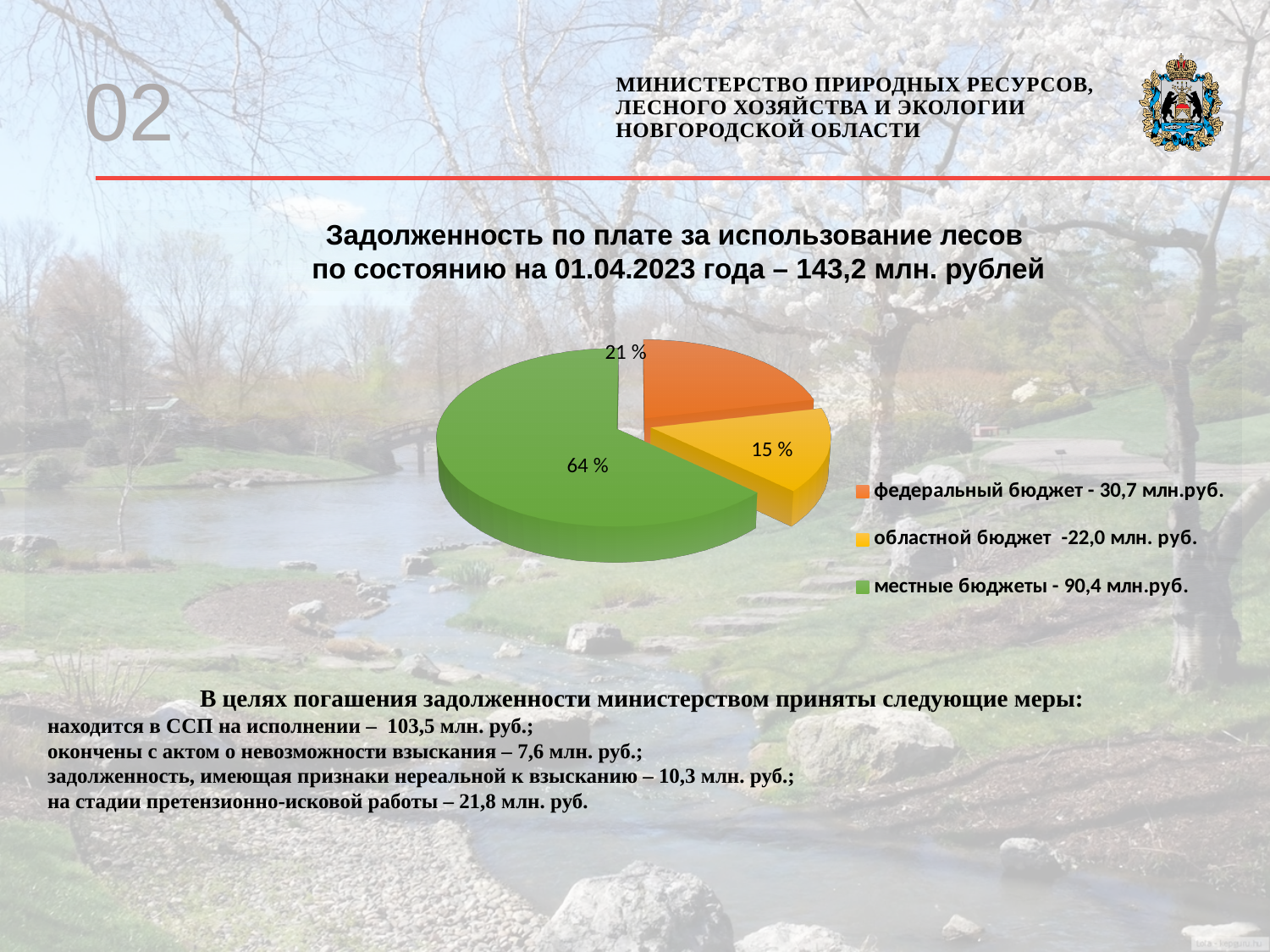
By how many percentage points does the share of местные бюджеты exceed the share of федеральный бюджет? 43 Which category has the largest slice of the pie? местные бюджеты What share of the pie does федеральный бюджет take? 21 % What share of the pie does местные бюджеты take? 64 % According to the legend, what is the debt amount for местные бюджеты? 90,4 млн.руб. Which is larger, the slice for федеральный бюджет or the slice for областной бюджет? федеральный бюджет How many slices does the pie chart have? 3 What colour is the slice for федеральный бюджет? orange What kind of chart is shown on the slide? pie chart According to the legend, what is the debt amount for областной бюджет? 22,0 млн. руб. Which category has the smallest slice of the pie? областной бюджет What share of the pie does областной бюджет take? 15 %